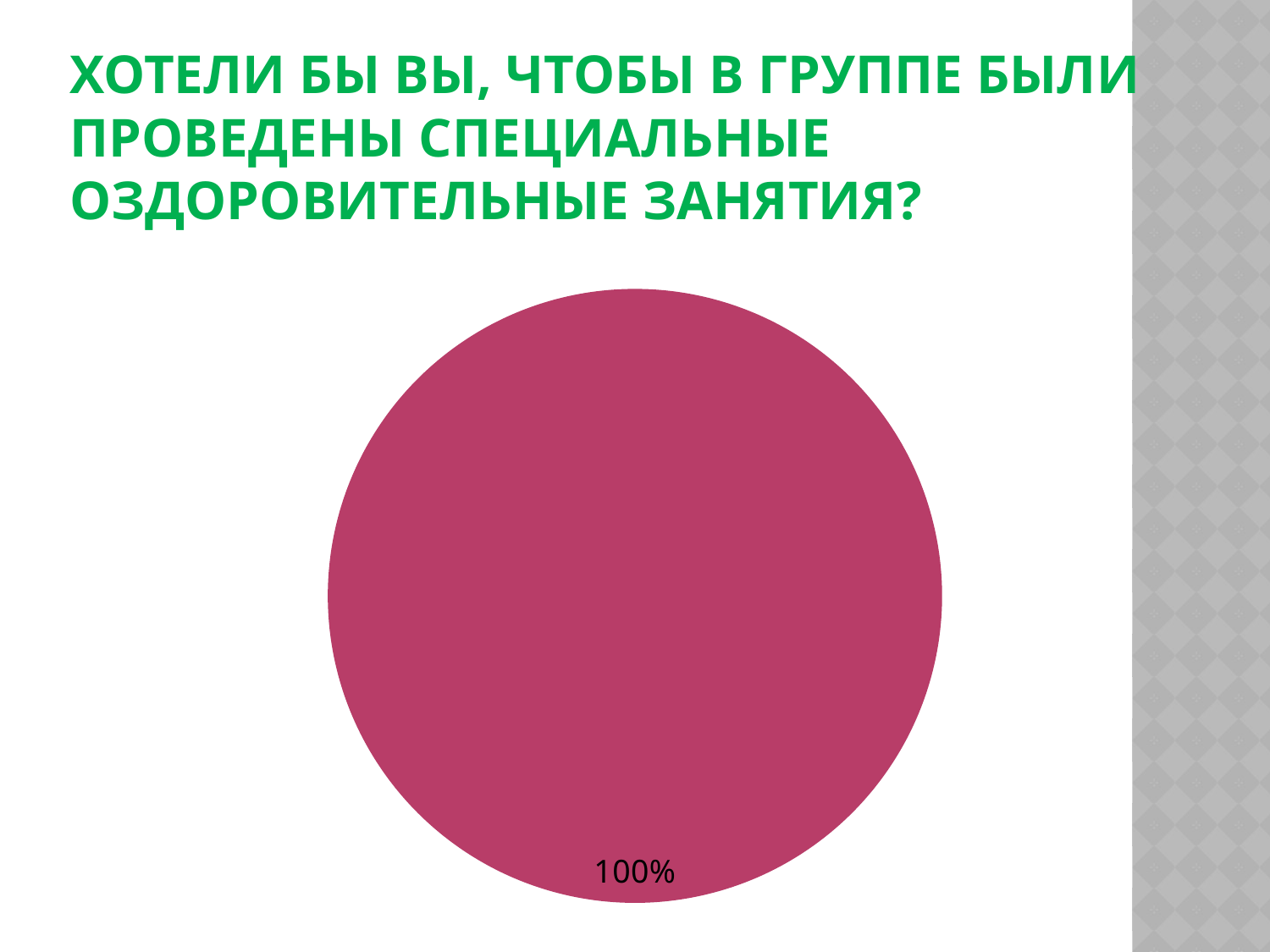
How many slices does the pie chart have? 1 Does the pie chart have a legend? No What percentage is printed as the data label on the pie chart? 100% What kind of chart is shown on the slide? pie chart Is the value shown on the pie chart greater or less than 50%? greater What colour is the slice of the pie chart? magenta (dark pink) What share of the pie does the single slice take up? 100%